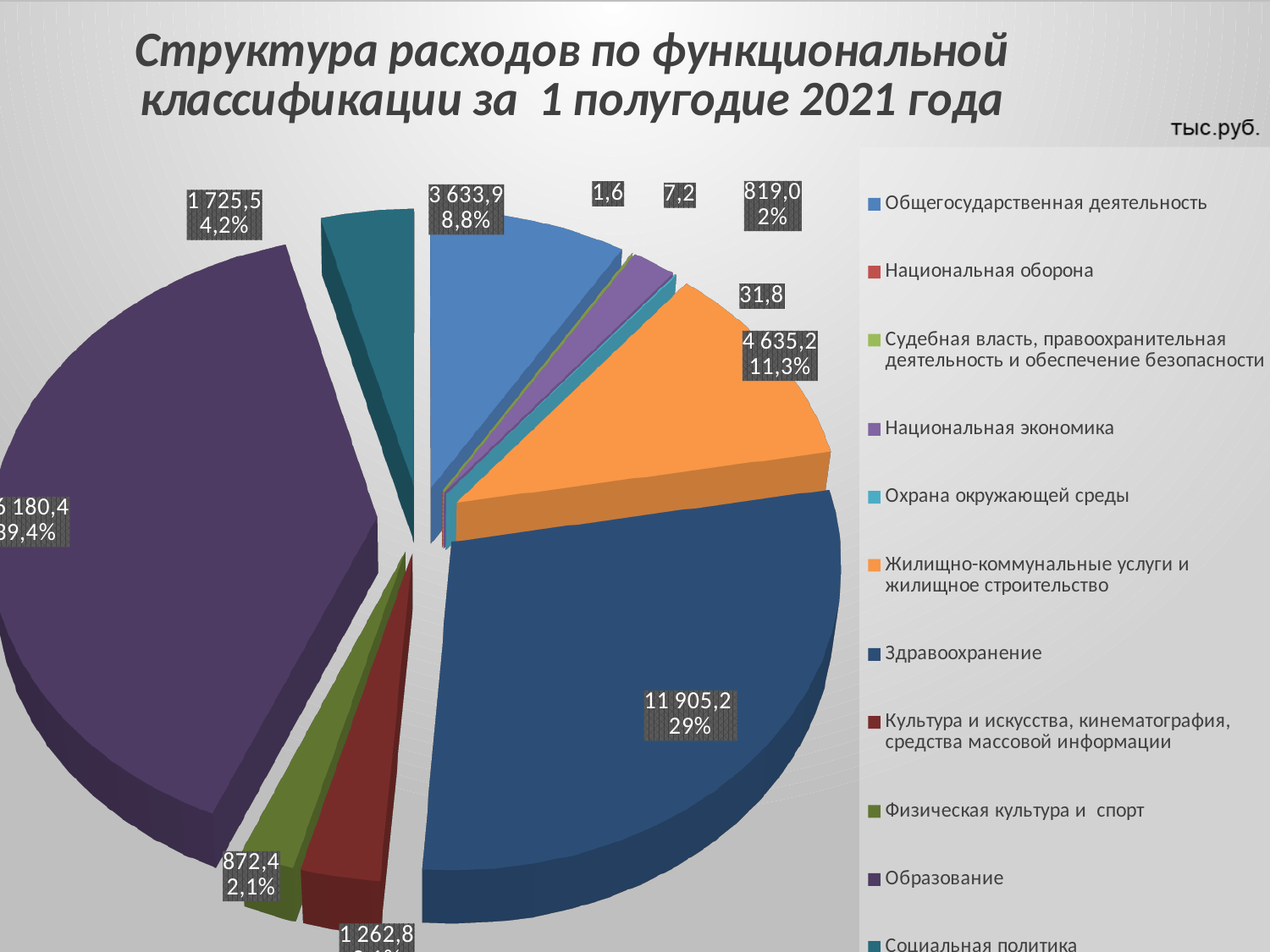
How many categories does the legend of the pie chart list? 11 What is the difference between the values for Здравоохранение and Жилищно-коммунальные услуги и жилищное строительство? 7 270,0 What is the value shown for Здравоохранение? 11 905,2 What share of the pie does Здравоохранение account for? 29% Which category has the smallest slice of the pie? Национальная оборона What kind of chart is shown on the slide? pie chart What is the value shown for Общегосударственная деятельность? 3 633,9 What share of the pie does Жилищно-коммунальные услуги и жилищное строительство account for? 11,3% What is the value shown for Жилищно-коммунальные услуги и жилищное строительство? 4 635,2 Which category has the largest slice of the pie? Образование In what units are the values on the chart given, according to the slide? тыс.руб. Which is larger, the value for Здравоохранение or the value for Жилищно-коммунальные услуги и жилищное строительство? Здравоохранение